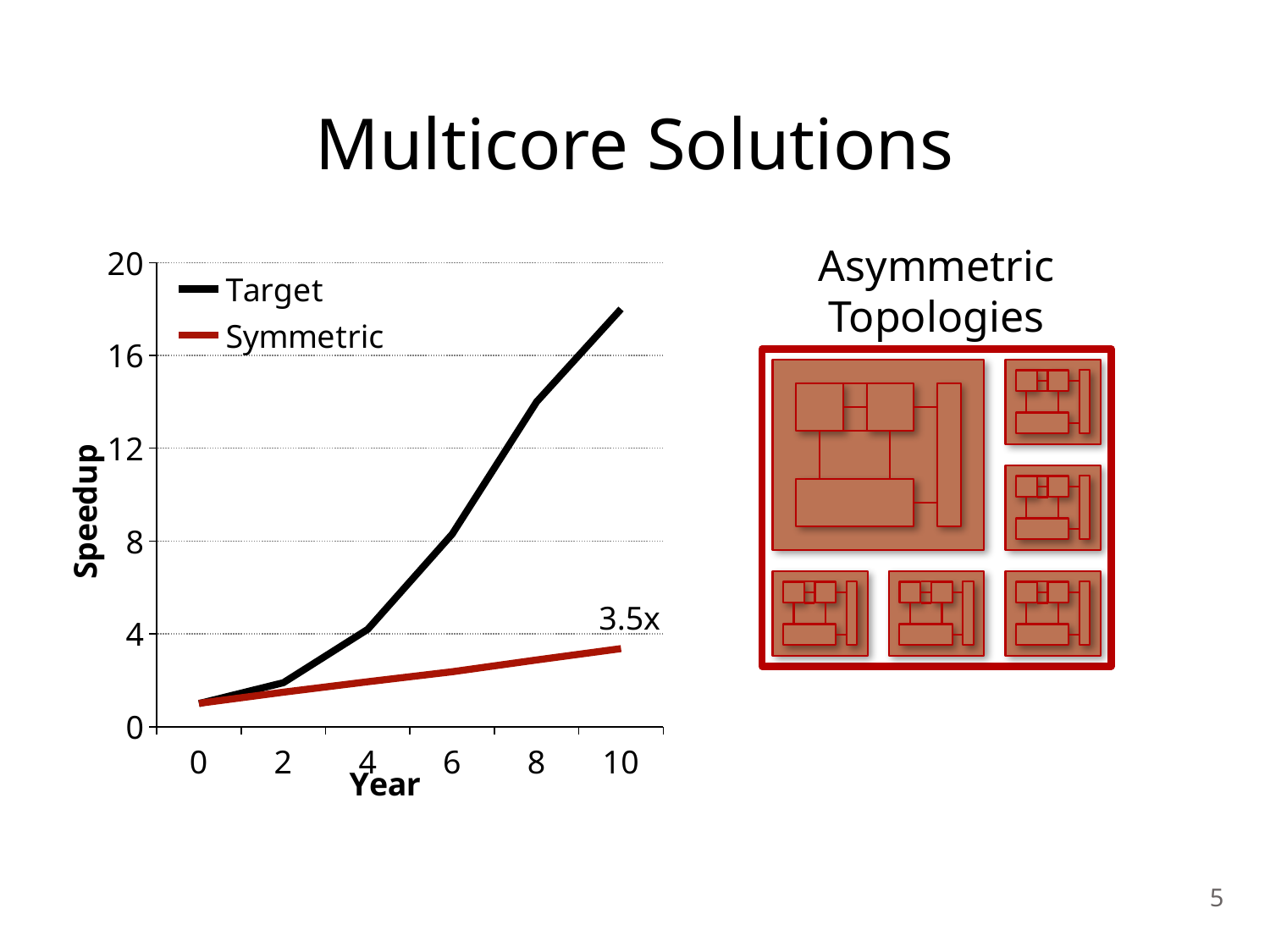
How many tick labels are shown on the Year axis? 6 How many series does the chart legend list? 2 Is the Symmetric speedup at year 10 greater or less than 4? less At year 10, which series has the higher speedup, Target or Symmetric? Target What is the title of the chart's vertical axis? Speedup What value label is printed at the end of the Symmetric line at year 10? 3.5x What are the two series named in the chart legend? Target and Symmetric Is the Target speedup at year 10 greater or less than 16? greater What type of chart is shown on the slide? line chart Does the Target speedup rise or fall as the year increases from 0 to 10? rise Is the Target speedup at year 6 greater or less than 4? greater